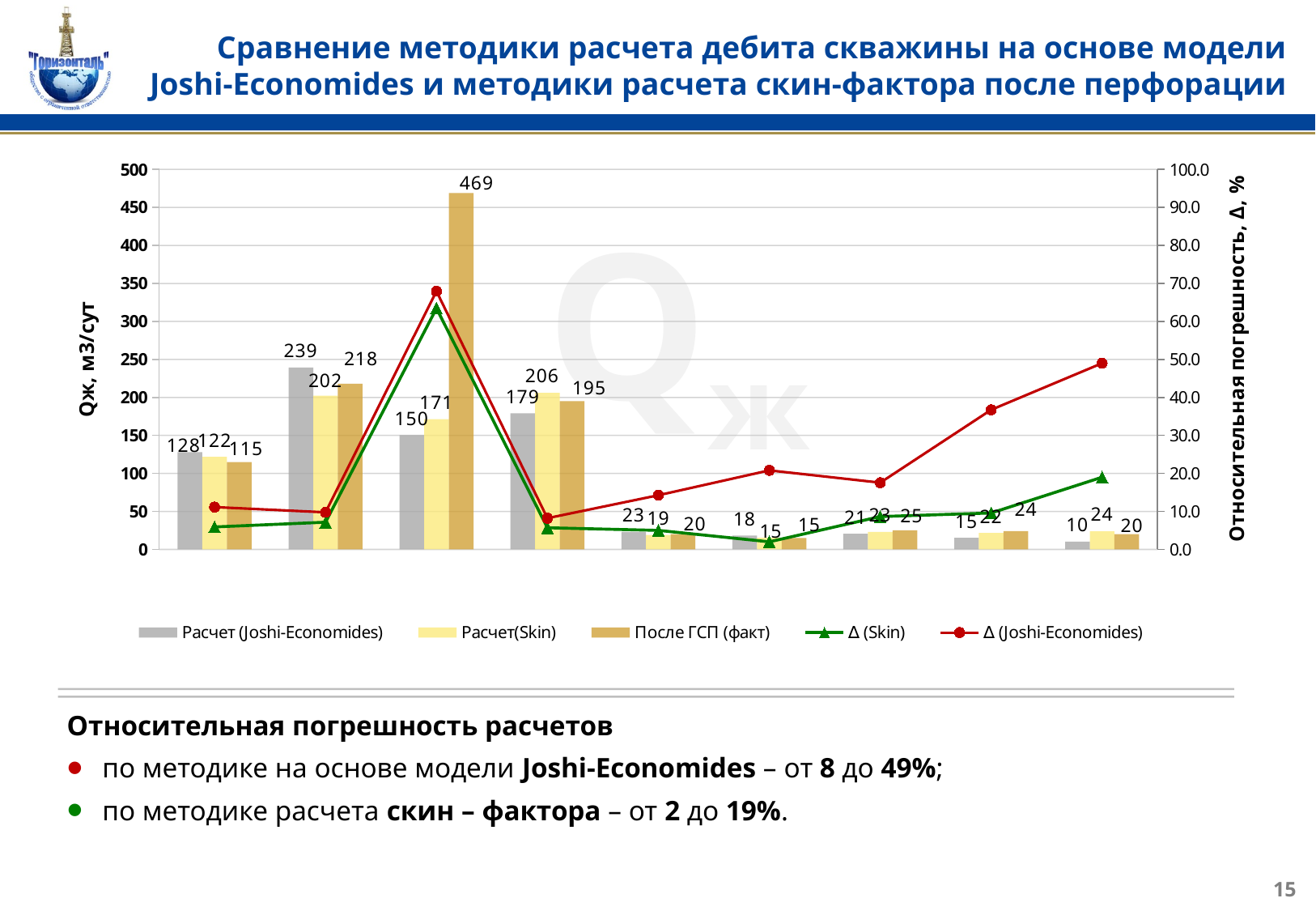
What is the lowest value of the 'Расчет (Joshi-Economides)' series? 10 In the third group of bars, what is the difference between 'После ГСП (факт)' (469) and 'Расчет(Skin)' (171)? 298 What is the value of 'Расчет (Joshi-Economides)' in the second group of bars? 239 Is the value of 'Δ (Skin)' at the third group greater or less than 50.0 on the right axis? greater What is the value of 'Расчет(Skin)' in the fourth group of bars? 206 What is the highest value of the 'После ГСП (факт)' series? 469 In the second group of bars, which is larger: 'Расчет(Skin)' or 'После ГСП (факт)'? После ГСП (факт) What kind of chart is shown on the slide? Combined bar and line chart How many series does the legend list? 5 Is the value of 'Δ (Joshi-Economides)' at the last group greater or less than 40.0 on the right axis? greater What is the title of the left vertical axis? Qж, м3/сут How many groups of bars are plotted along the x axis? 9